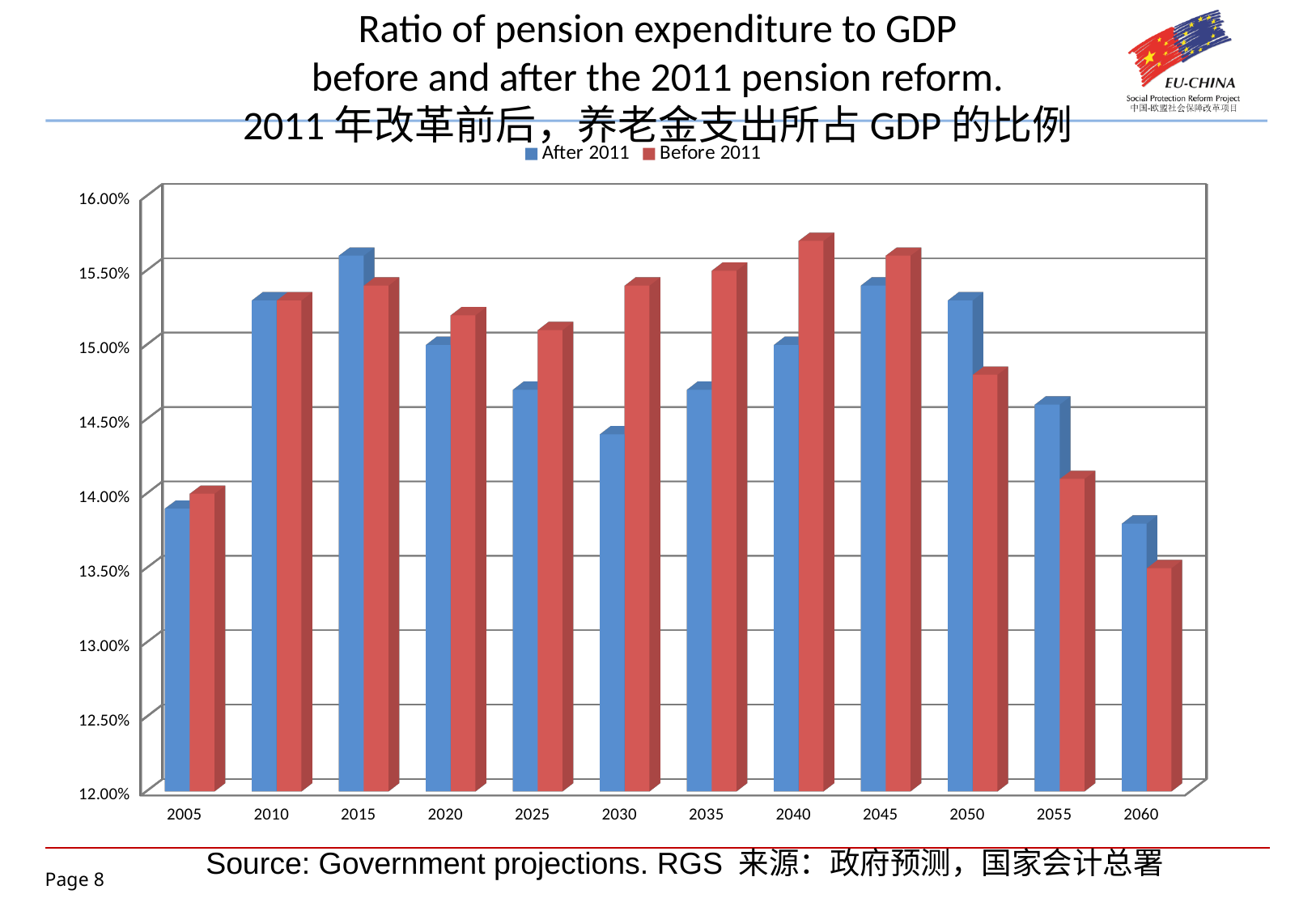
Is the After 2011 value for 2060 greater or less than 14.00%? less Is the Before 2011 value for 2040 greater or less than 15.50%? greater In which year is the Before 2011 value highest? 2040 In which year is the Before 2011 value lowest? 2060 For 2050, which series has the larger value, After 2011 or Before 2011? After 2011 How many years are shown along the x axis? 12 Is the Before 2011 value for 2050 greater or less than 15.00%? less In which year is the After 2011 value highest? 2015 Do the Before 2011 values rise or fall from 2040 to 2060? fall What kind of chart is shown on the slide? bar chart For 2030, which series has the larger value, After 2011 or Before 2011? Before 2011 How many series does the legend list? 2